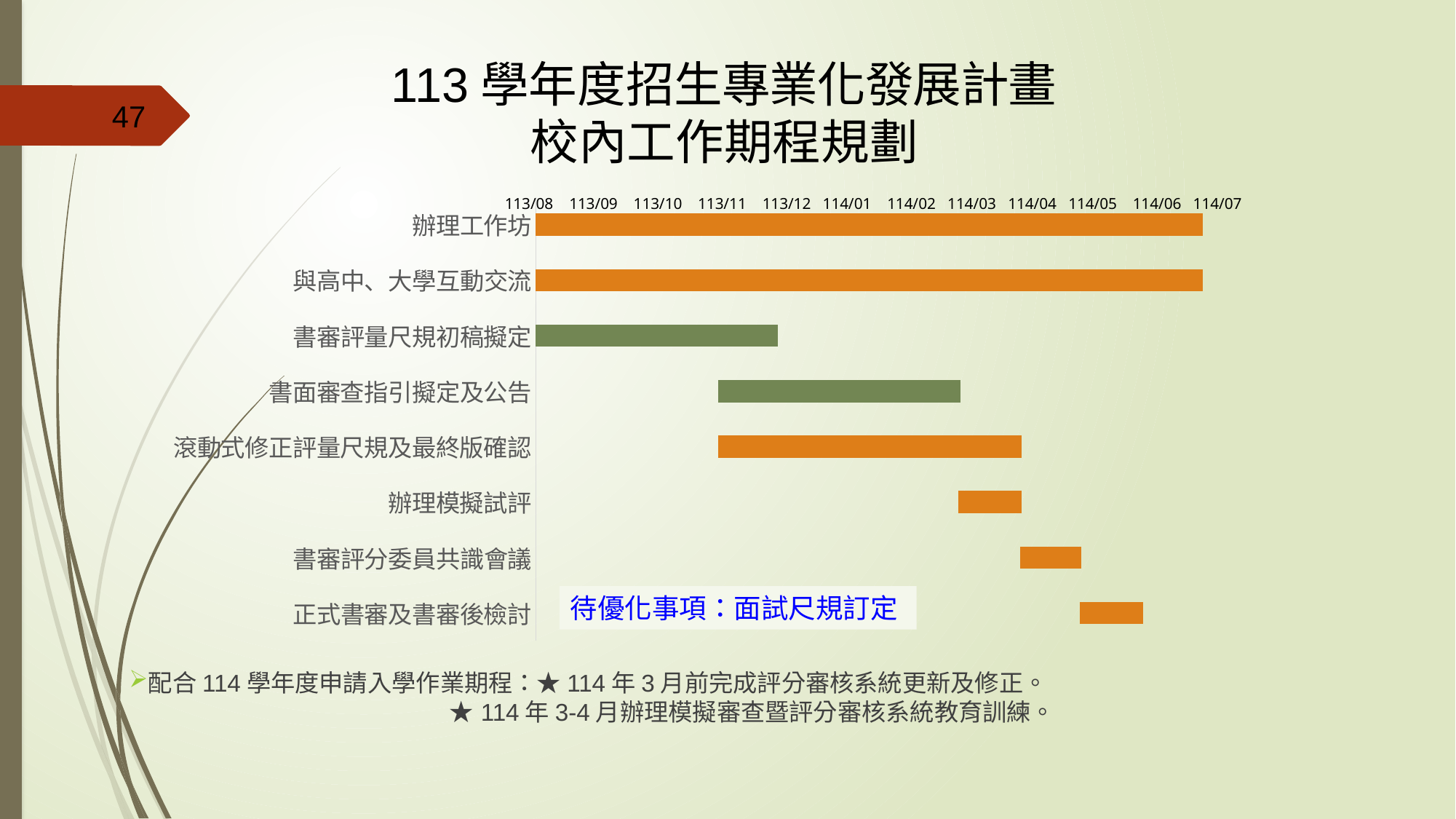
What kind of chart is shown on the slide? Bar chart In which month does the bar for 辦理模擬試評 start? 114/03 In which month does the bar for 正式書審及書審後檢討 start? 114/05 Which task starts earlier, 書面審查指引擬定及公告 or 辦理模擬試評? 書面審查指引擬定及公告 How many bars on the chart are coloured green rather than orange? 2 In which month does the bar for 滾動式修正評量尺規及最終版確認 end? 114/04 How many tasks (categories) are listed on the chart? 8 Which task ends later, 滾動式修正評量尺規及最終版確認 or 書面審查指引擬定及公告? 滾動式修正評量尺規及最終版確認 In which month does the bar for 書審評量尺規初稿擬定 start? 113/08 In which month does the bar for 書審評量尺規初稿擬定 end? 113/12 In which month does the bar for 書面審查指引擬定及公告 start? 113/11 How many month labels are shown along the top axis of the chart? 12